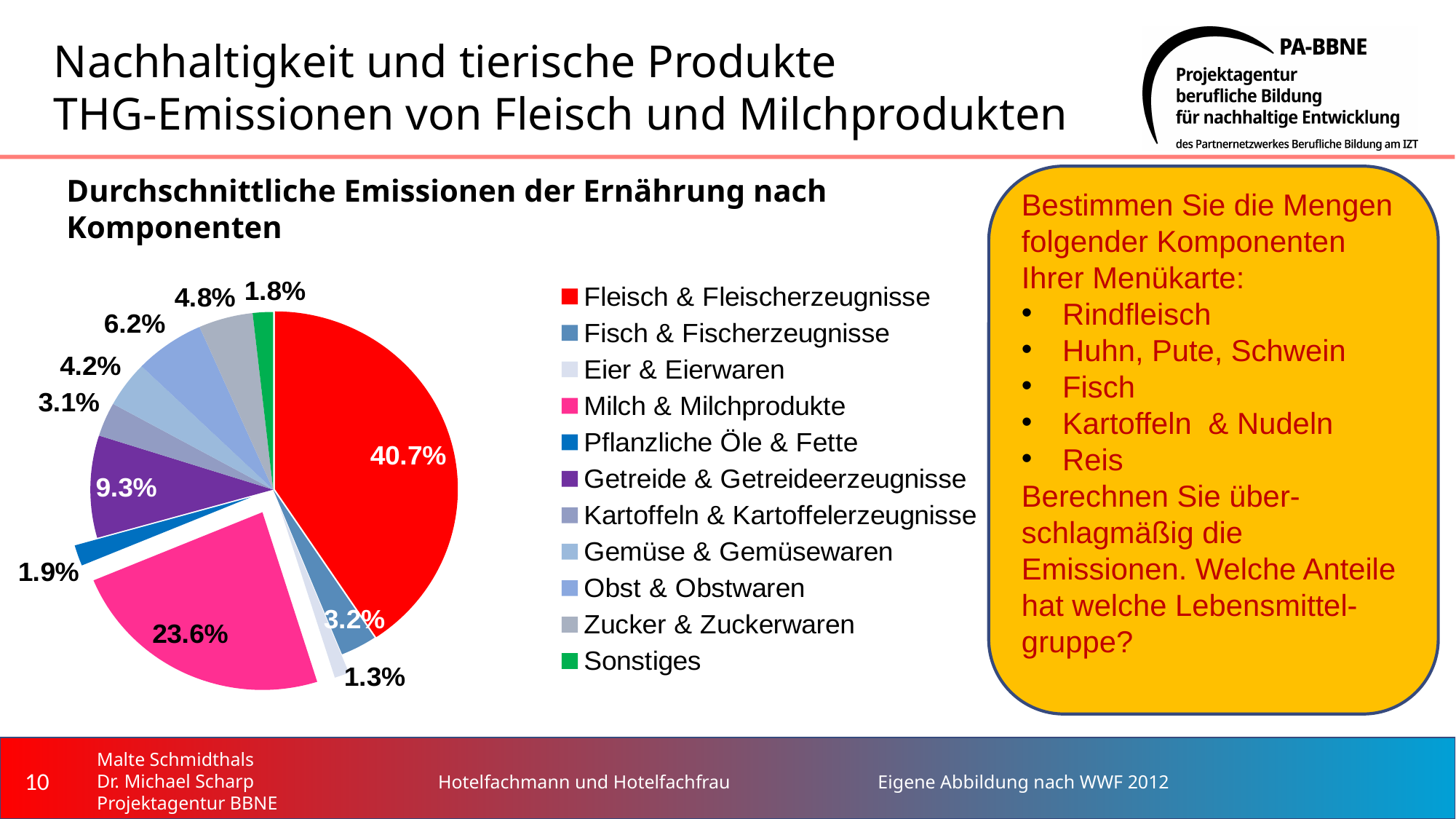
Which is larger, the share for Fisch & Fischerzeugnisse or the share for Zucker & Zuckerwaren? Zucker & Zuckerwaren Which category has the largest share of the pie? Fleisch & Fleischerzeugnisse What is the value shown for Getreide & Getreideerzeugnisse? 9.3% How many categories does the legend of the pie chart list? 11 What kind of chart is shown on the slide? pie chart What is the value shown for Obst & Obstwaren? 6.2% Which category has the smallest share of the pie? Eier & Eierwaren What share of the pie does Milch & Milchprodukte have? 23.6% What share of the pie does Fleisch & Fleischerzeugnisse have? 40.7% What is the difference between the shares of Fleisch & Fleischerzeugnisse and Milch & Milchprodukte? 17.1% What is the title of the chart? Durchschnittliche Emissionen der Ernährung nach Komponenten Which colour represents Sonstiges in the pie chart? green